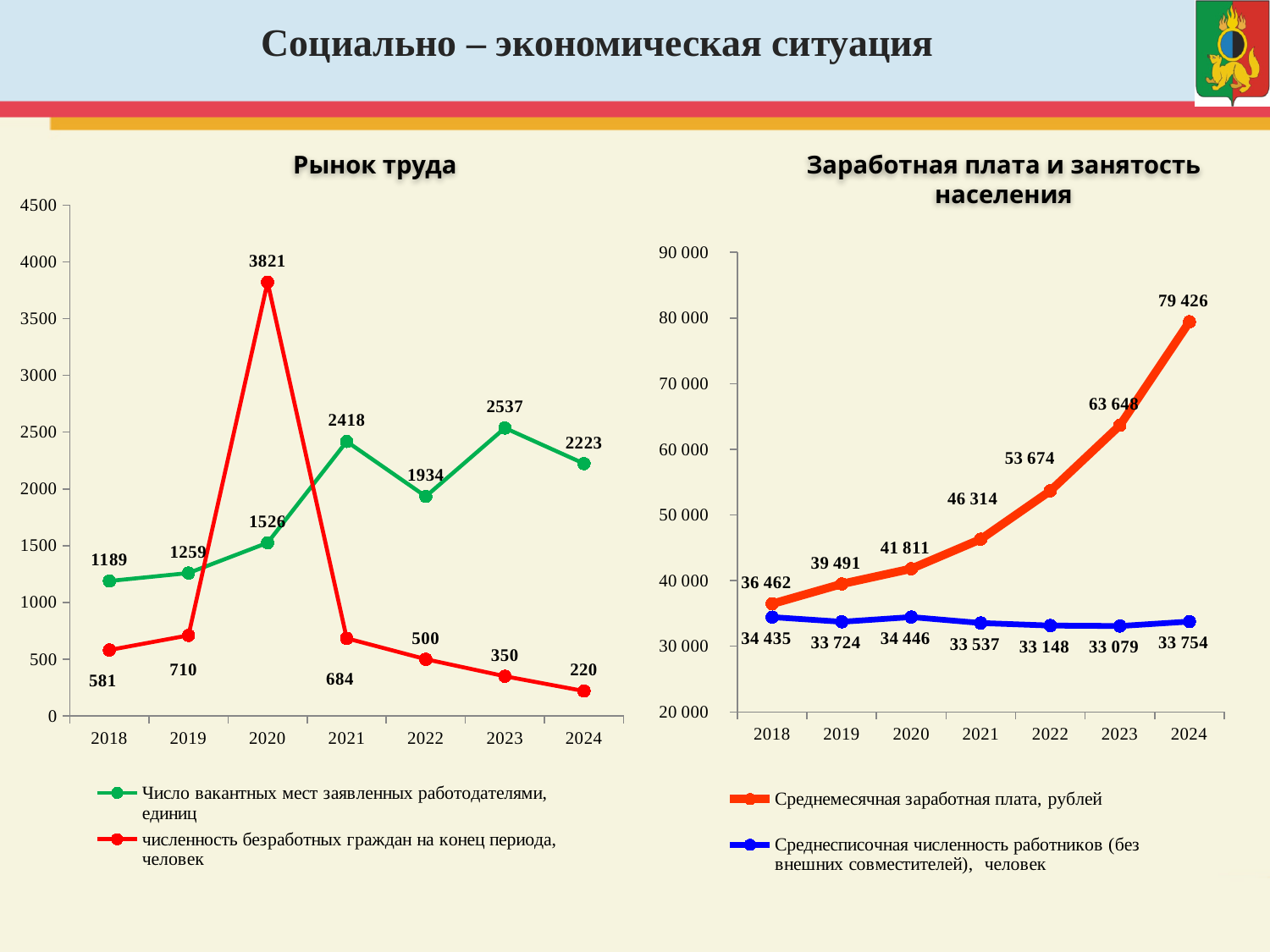
In the 'Заработная плата и занятость населения' chart, in which year is the average headcount of employees the lowest? 2023 In the 'Заработная плата и занятость населения' chart, does the average monthly salary rise or fall from 2018 to 2024? Rise In the 'Рынок труда' chart, what is the number of vacancies declared by employers in 2023? 2537 In the 'Рынок труда' chart, which is larger in 2019: the number of vacancies or the number of unemployed citizens? Number of vacancies In the 'Заработная плата и занятость населения' chart, what is the difference between the average monthly salary in 2024 and in 2023? 15 778 In the 'Заработная плата и занятость населения' chart, what is the average monthly salary in 2022? 53 674 What kind of chart is 'Заработная плата и занятость населения'? Line chart In the 'Рынок труда' chart, what is the difference between the number of vacancies in 2021 and in 2022? 484 In the 'Рынок труда' chart, how many series does the legend list? 2 In the 'Рынок труда' chart, what is the number of unemployed citizens at the end of the period in 2020? 3821 In the 'Рынок труда' chart, in which year is the number of vacancies declared by employers the lowest? 2018 How many years are shown on the x axis of the 'Рынок труда' chart? 7